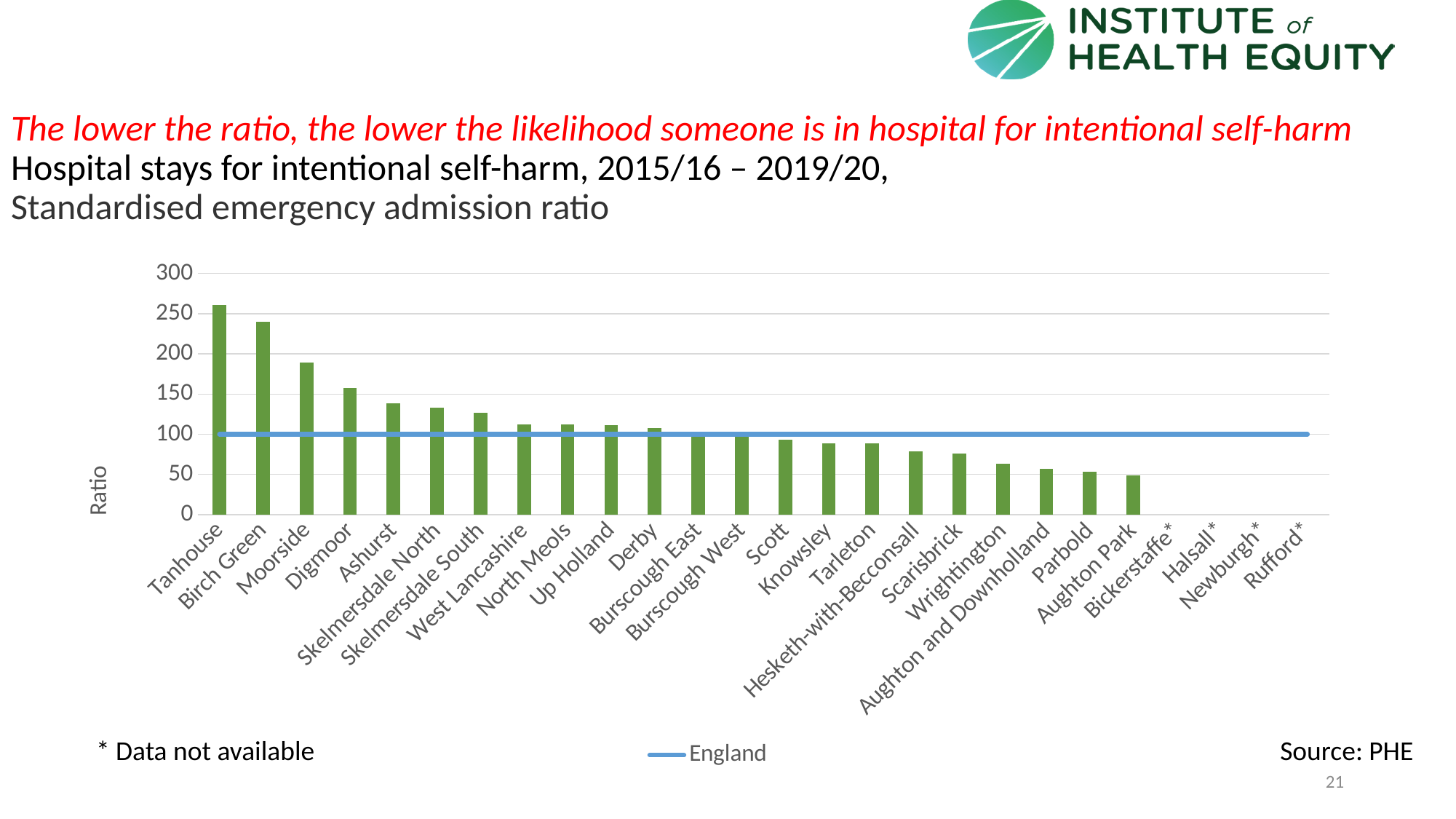
Is the ratio for Wrightington greater or less than 50? greater Which area has the highest standardised emergency admission ratio? Tanhouse What kind of chart is shown on the slide? bar chart Is the ratio for Tanhouse greater or less than 250? greater How many areas are marked with an asterisk as data not available? 4 What value does the England reference line sit at? 100 Among the areas with a bar shown, which has the lowest ratio? Aughton Park Is the ratio for Knowsley greater or less than 100? less Do the bar values rise or fall moving from left to right along the x axis? fall Which has the higher ratio, Moorside or Digmoor? Moorside